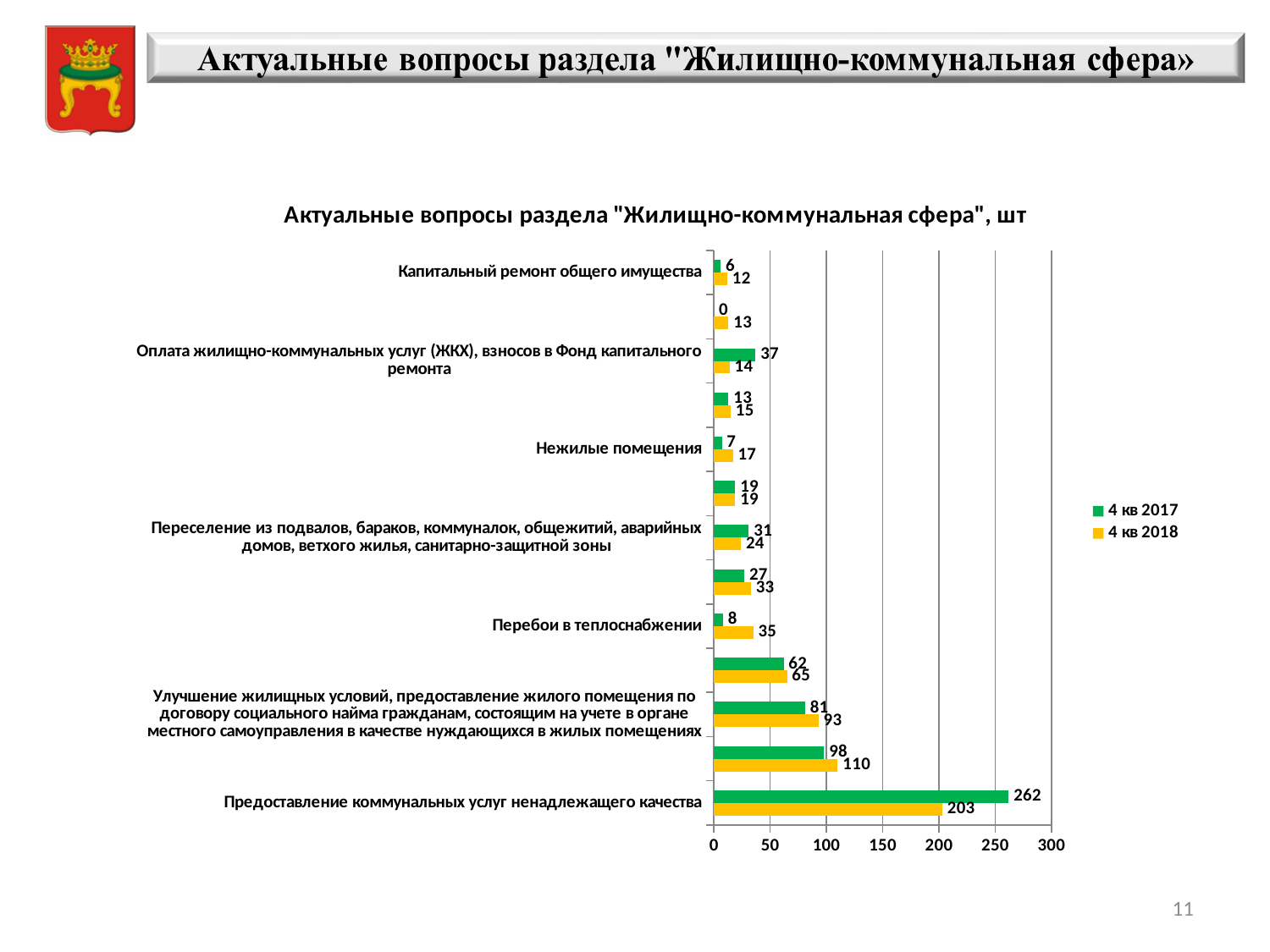
What is the difference between the "4 кв 2017" and "4 кв 2018" values for "Предоставление коммунальных услуг ненадлежащего качества"? 59 What type of chart is shown on the slide? bar chart How many categories (pairs of bars) are plotted on the chart? 13 What is the value for "Предоставление коммунальных услуг ненадлежащего качества" in the "4 кв 2017" series? 262 How many series does the legend list? 2 For "Оплата жилищно-коммунальных услуг (ЖКХ), взносов в Фонд капитального ремонта", which series has the larger value, "4 кв 2017" or "4 кв 2018"? 4 кв 2017 What is the value for "Капитальный ремонт общего имущества" in the "4 кв 2018" series? 12 What is the value for "Предоставление коммунальных услуг ненадлежащего качества" in the "4 кв 2018" series? 203 What is the value for "Нежилые помещения" in the "4 кв 2017" series? 7 Which category has the highest value in the "4 кв 2017" series? Предоставление коммунальных услуг ненадлежащего качества What is the value for "Перебои в теплоснабжении" in the "4 кв 2018" series? 35 For "Перебои в теплоснабжении", which series has the larger value, "4 кв 2017" or "4 кв 2018"? 4 кв 2018